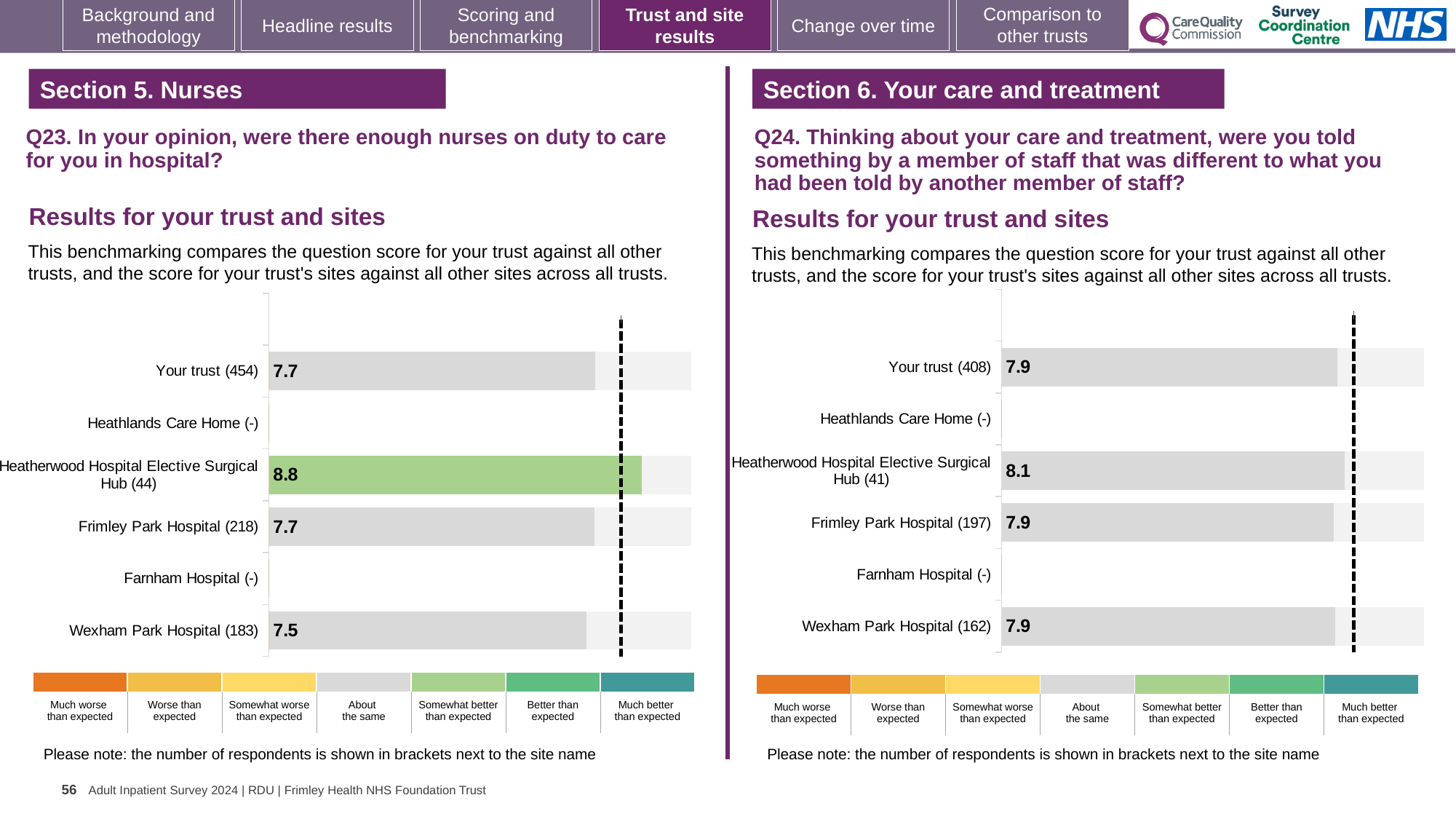
In the Q23 chart on the left, which site has the highest score? Heatherwood Hospital Elective Surgical Hub (44) In the Q24 chart on the right, which site has the highest score? Heatherwood Hospital Elective Surgical Hub (41) In the Q23 chart on the left, what is the difference between the scores for Heatherwood Hospital Elective Surgical Hub (44) and Wexham Park Hospital (183)? 1.3 What type of chart is used for the Q23 results on the left? Bar chart In the Q24 chart on the right, what is the score for Heatherwood Hospital Elective Surgical Hub (41)? 8.1 In the Q23 chart on the left, what is the score for Your trust (454)? 7.7 In the Q23 chart on the left, how many site/trust categories are listed on the vertical axis? 6 In the Q23 chart on the left, which benchmark category does the green colour of the Heatherwood Hospital Elective Surgical Hub bar represent according to the legend? Somewhat better than expected In the Q23 chart on the left, what is the score for Heatherwood Hospital Elective Surgical Hub (44)? 8.8 In the Q24 chart on the right, what is the difference between the scores for Heatherwood Hospital Elective Surgical Hub (41) and Your trust (408)? 0.2 In the Q23 chart on the left, which site with a plotted score has the lowest score? Wexham Park Hospital (183) In the Q24 chart on the right, what is the score for Wexham Park Hospital (162)? 7.9